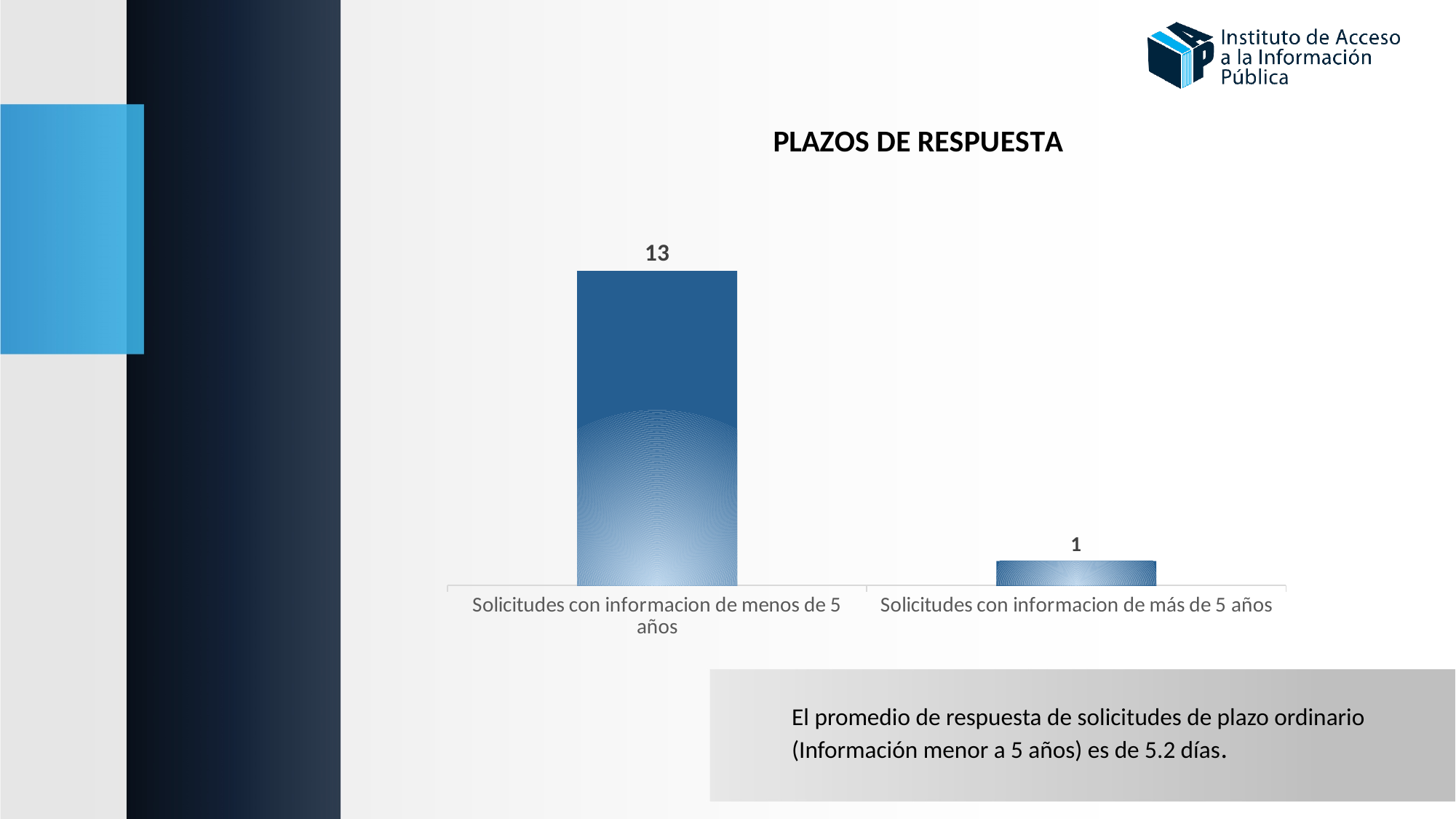
What is the title of the chart? PLAZOS DE RESPUESTA What is the value for "Solicitudes con informacion de menos de 5 años"? 13 How many categories are shown in the chart? 2 Which category has the lowest value? Solicitudes con informacion de más de 5 años What is the total of the two values shown in the chart? 14 What is the value for "Solicitudes con informacion de más de 5 años"? 1 Which category has the highest value? Solicitudes con informacion de menos de 5 años What is the difference between the values for "Solicitudes con informacion de menos de 5 años" and "Solicitudes con informacion de más de 5 años"? 12 Which is larger: the value for "Solicitudes con informacion de menos de 5 años" or for "Solicitudes con informacion de más de 5 años"? Solicitudes con informacion de menos de 5 años What kind of chart is shown on the slide? Bar chart